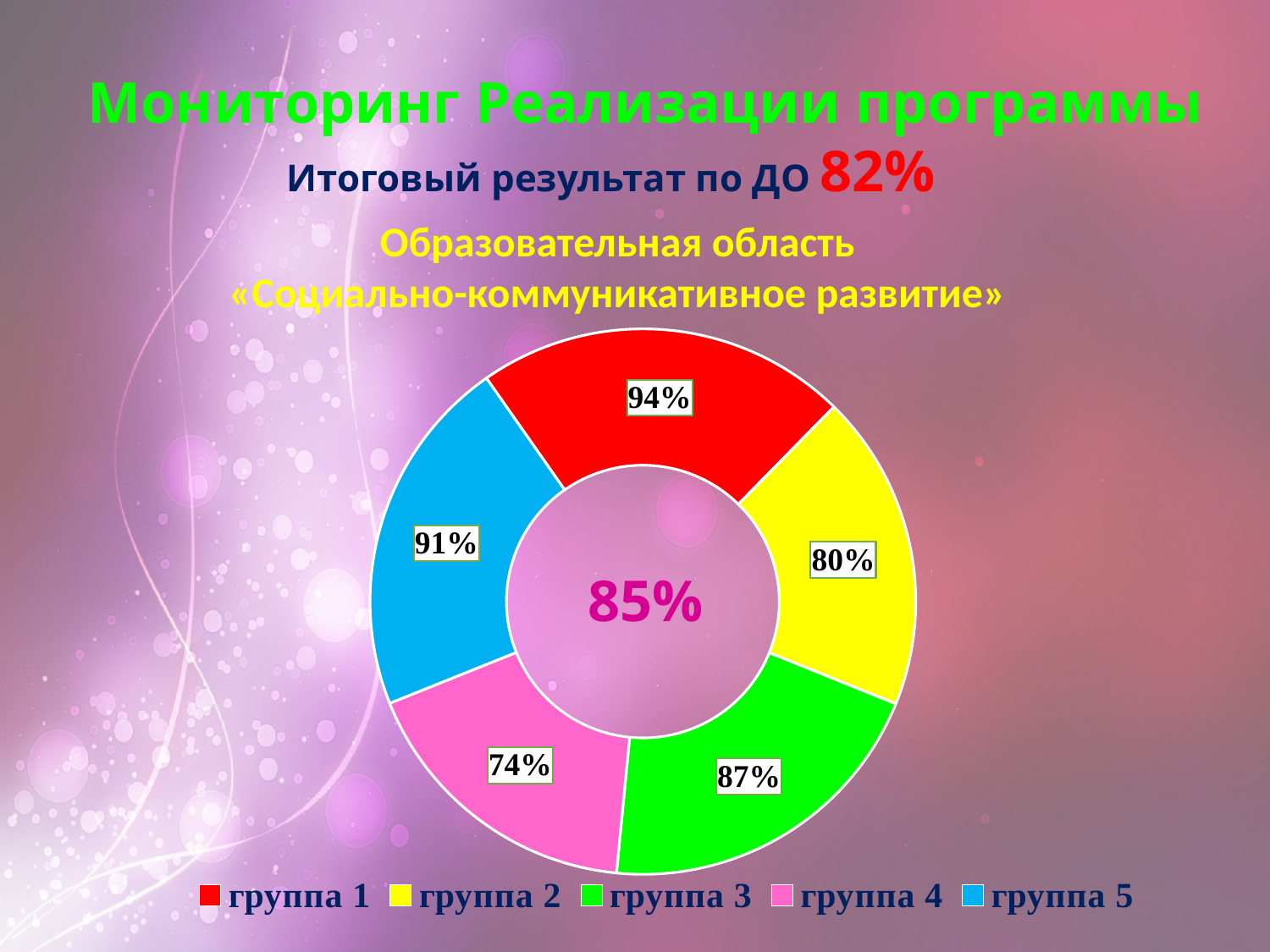
Which group has the lowest value? группа 4 Which is larger, the value for группа 3 or the value for группа 2? группа 3 What value is shown for группа 1? 94% What value is shown for группа 5? 91% What is the difference between the values for группа 1 and группа 4? 20% What value is printed in the centre of the doughnut chart? 85% What kind of chart is shown on the slide? doughnut chart What value is shown for группа 2? 80% Which group has the highest value? группа 1 How many groups are shown in the chart? 5 What value is shown for группа 4? 74% What value is shown for группа 3? 87%